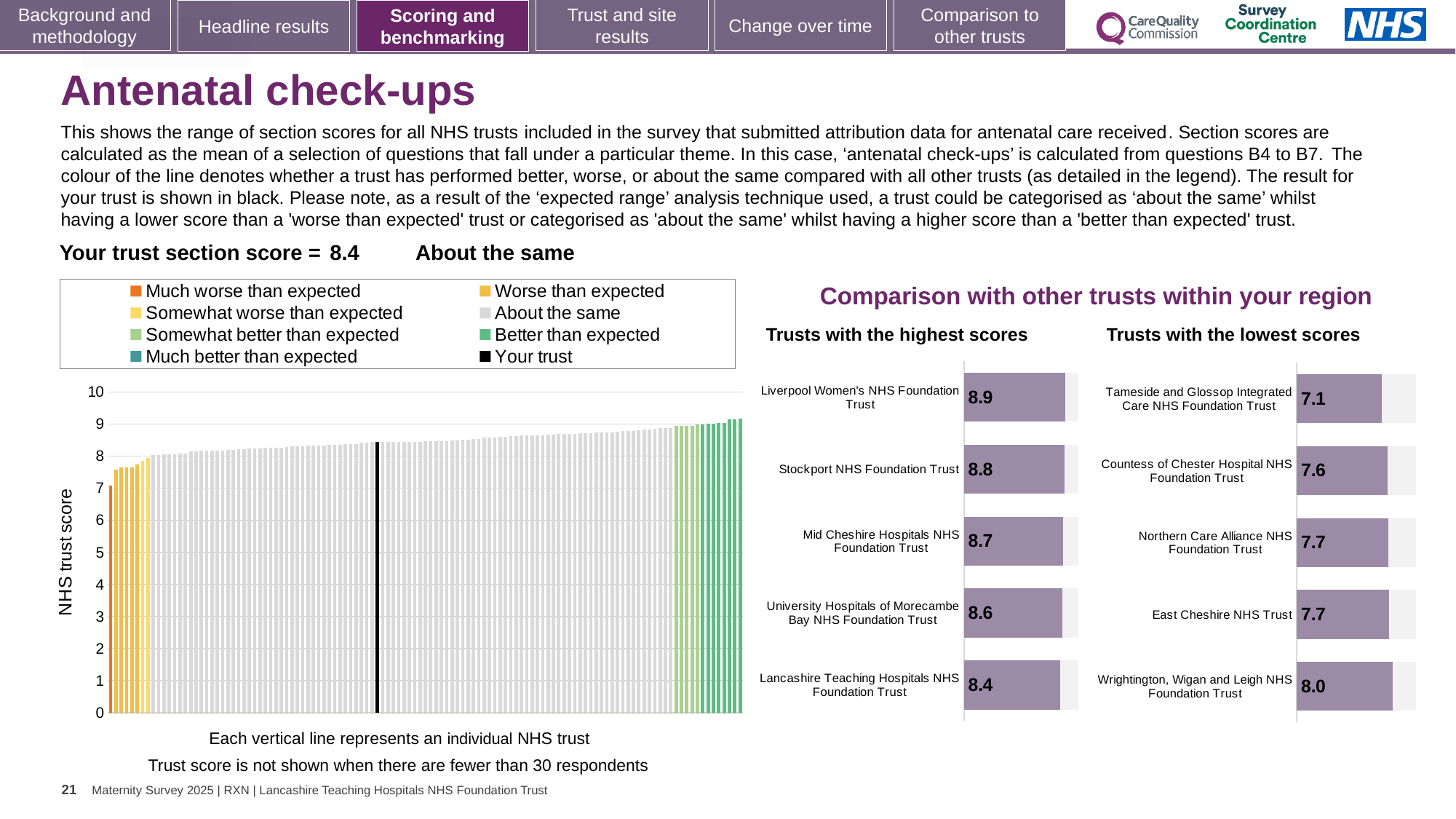
In the 'Trusts with the lowest scores' chart, which trust has the lowest score? Tameside and Glossop Integrated Care NHS Foundation Trust In the 'Trusts with the lowest scores' chart, what is the score for Wrightington, Wigan and Leigh NHS Foundation Trust? 8.0 In the 'Trusts with the highest scores' chart, what is the score for Stockport NHS Foundation Trust? 8.8 In the 'Trusts with the lowest scores' chart, what is the score for Tameside and Glossop Integrated Care NHS Foundation Trust? 7.1 In the 'Trusts with the highest scores' chart, what is the score for Liverpool Women's NHS Foundation Trust? 8.9 What kind of chart is the large chart on the left with the y-axis labelled 'NHS trust score'? Bar chart How many entries does the legend above the large 'NHS trust score' chart list? 8 How many trusts are listed in the 'Trusts with the highest scores' chart? 5 In the 'Trusts with the highest scores' chart, which trust has the highest score? Liverpool Women's NHS Foundation Trust In the 'Trusts with the lowest scores' chart, which has the higher score: Countess of Chester Hospital NHS Foundation Trust or Tameside and Glossop Integrated Care NHS Foundation Trust? Countess of Chester Hospital NHS Foundation Trust In the 'Trusts with the highest scores' chart, what is the difference between the scores of Liverpool Women's NHS Foundation Trust and Lancashire Teaching Hospitals NHS Foundation Trust? 0.5 In the 'Trusts with the lowest scores' chart, what is the difference between the scores of Wrightington, Wigan and Leigh NHS Foundation Trust and Tameside and Glossop Integrated Care NHS Foundation Trust? 0.9